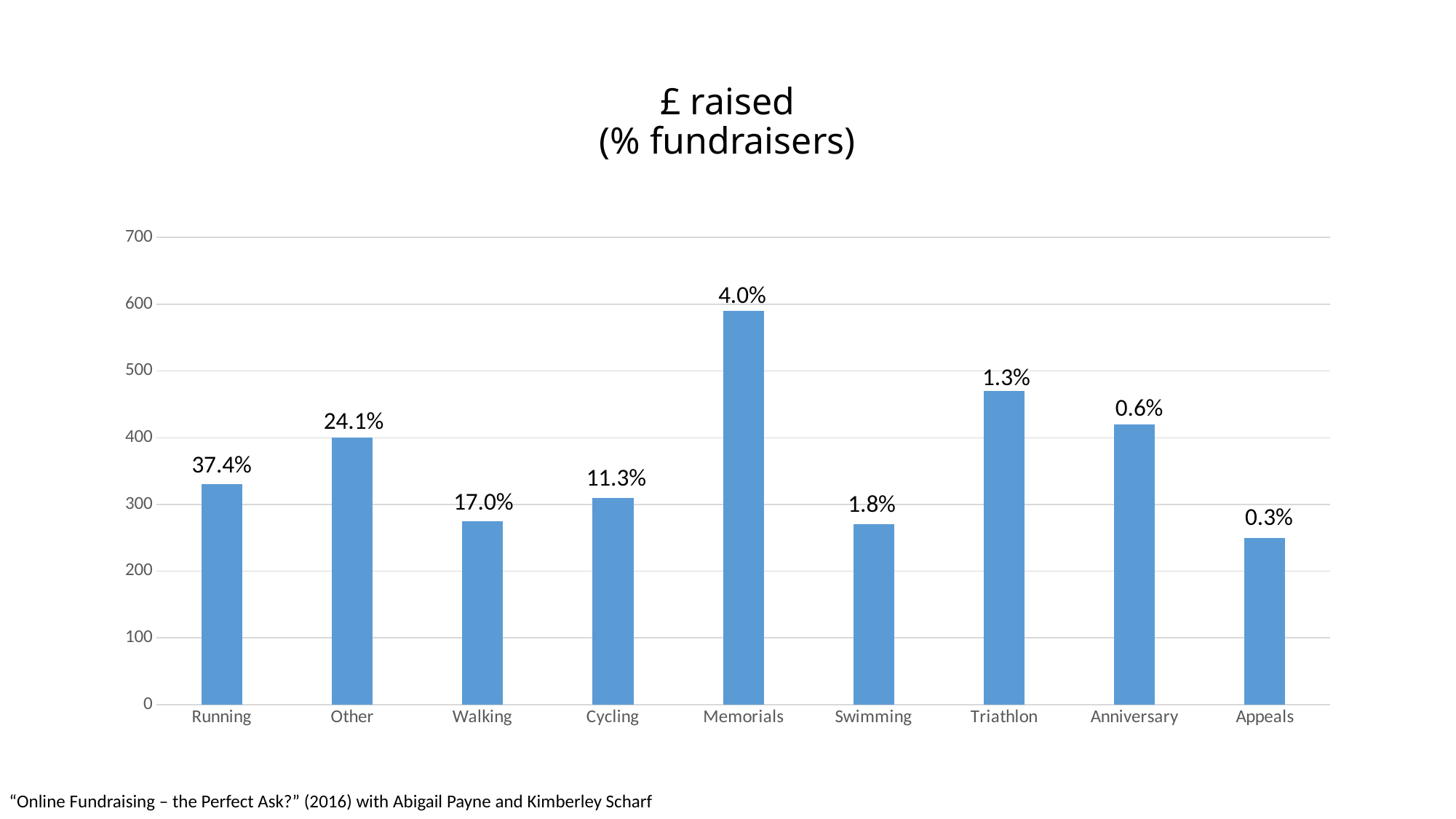
What kind of chart is shown on the slide? bar chart Which bar is taller, Triathlon or Anniversary? Triathlon Is the £ raised value for Walking greater or less than 300? less Which category has the tallest bar for £ raised? Memorials How many categories are shown on the x axis of the chart? 9 What is the title of the chart? £ raised (% fundraisers) Is the £ raised value for Memorials greater or less than 500? greater Which category has the shortest bar for £ raised? Appeals What is the difference between the percentage labels for Running and Other? 13.3% What percentage of fundraisers is labelled above the Appeals bar? 0.3% What percentage of fundraisers is labelled above the Running bar? 37.4% What percentage of fundraisers is labelled above the Memorials bar? 4.0%